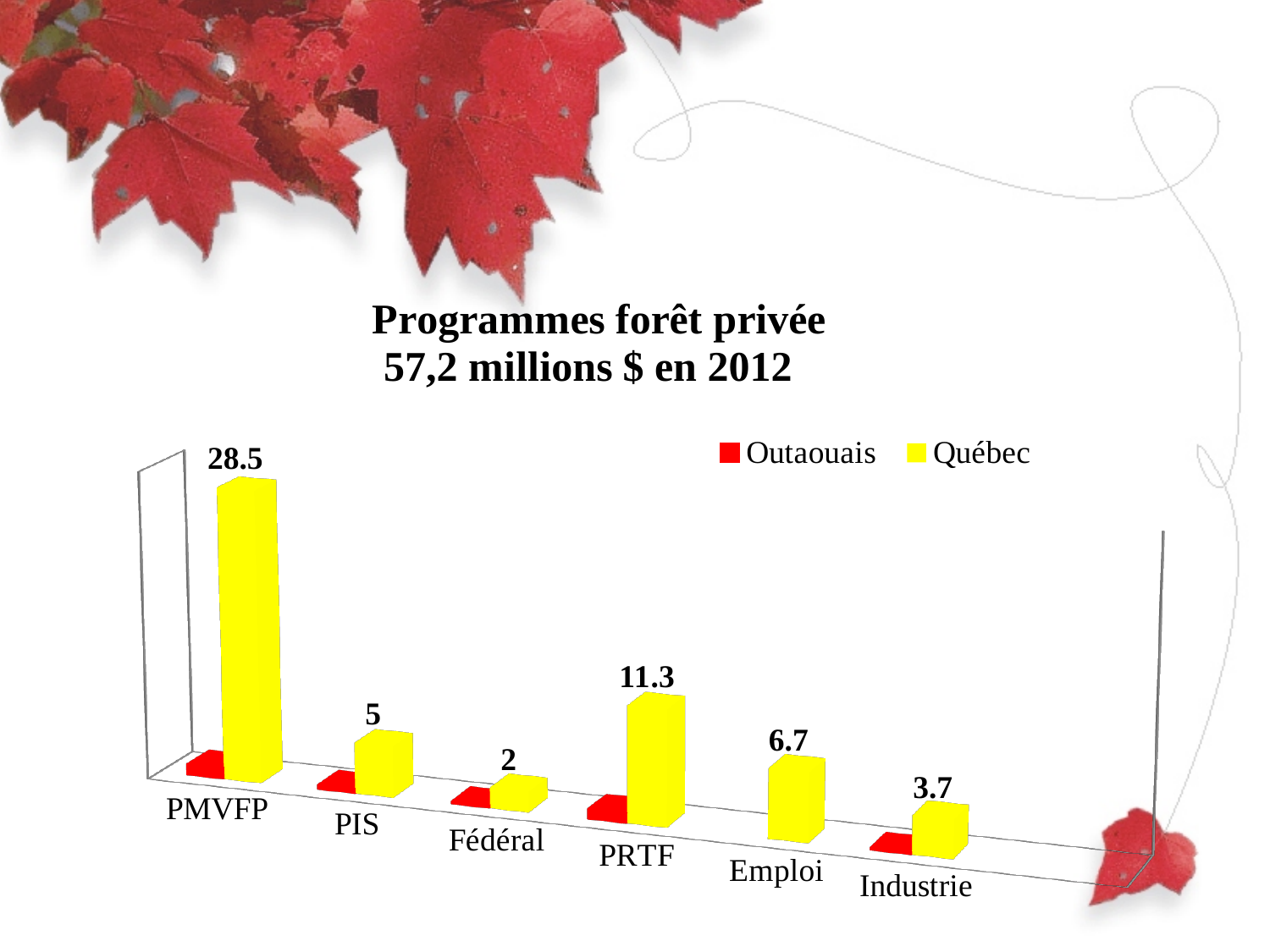
What is the Québec value for Emploi? 6.7 How many series does the legend list? 2 What kind of chart is shown on the slide? Bar chart What is the difference between the Québec values for PMVFP and PRTF? 17.2 Which has a larger Québec value, PIS or Emploi? Emploi How many categories are shown on the x axis? 6 Which colour represents the Outaouais series? Red Which category has the lowest Québec value? Fédéral What is the Québec value for PMVFP? 28.5 Which category has the highest Québec value? PMVFP What is the Québec value for PRTF? 11.3 What is the Québec value for Industrie? 3.7